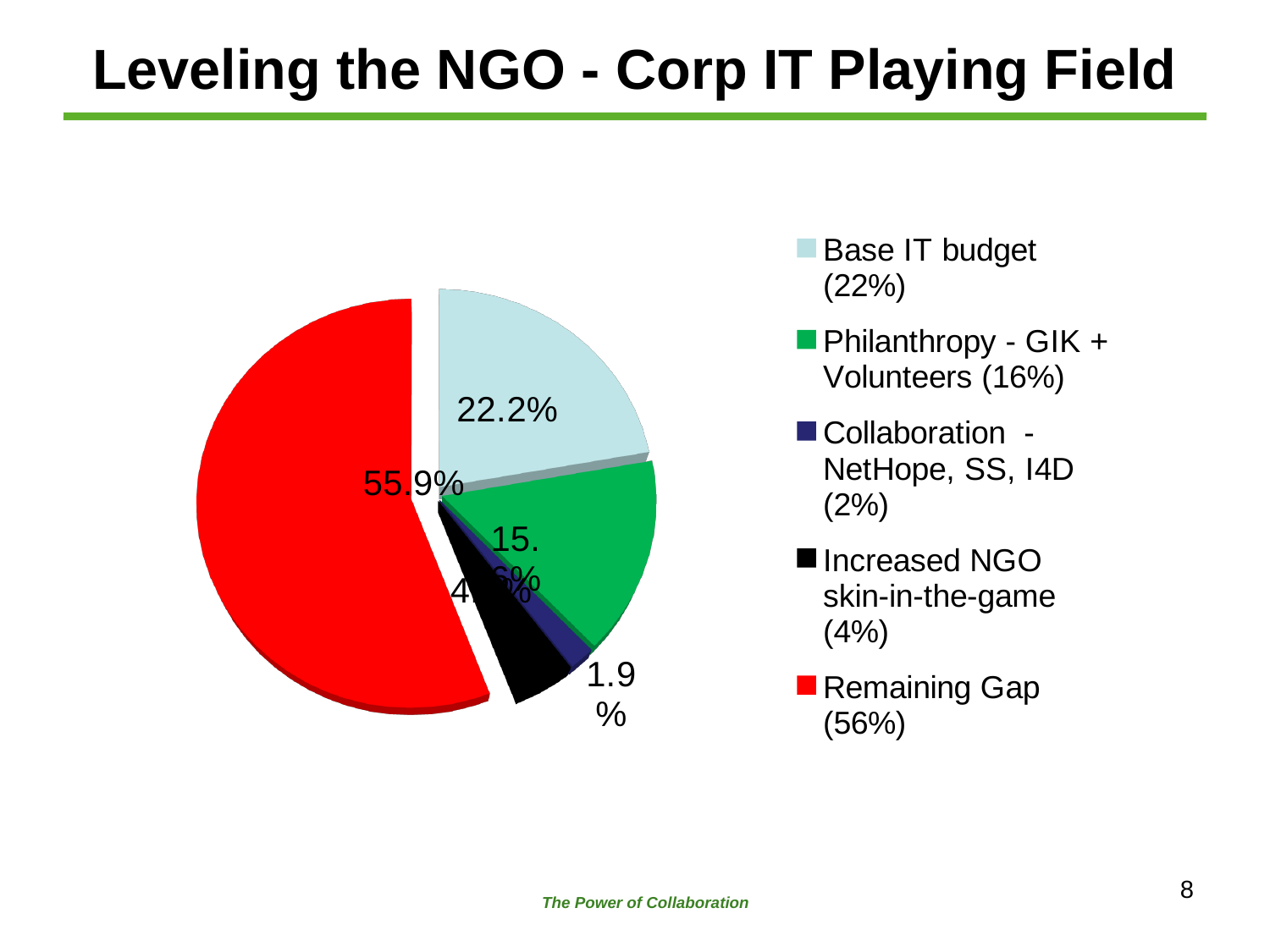
What is the difference in percentage points between the Remaining Gap slice (55.9%) and the Base IT budget slice (22.2%)? 33.7 percentage points What percentage does the legend give for Philanthropy - GIK + Volunteers? 16% Which is larger, the Base IT budget slice or the Remaining Gap slice? Remaining Gap Which is larger, the Base IT budget slice or the Philanthropy - GIK + Volunteers slice? Base IT budget What percentage does the Remaining Gap slice show? 55.9% What percentage does the Collaboration - NetHope, SS, I4D slice show? 1.9% How many slices does the pie chart have? 5 Which slice of the pie is the largest? Remaining Gap What percentage does the Base IT budget slice show? 22.2% What kind of chart is shown on the slide? Pie chart Which slice of the pie is the smallest? Collaboration - NetHope, SS, I4D What colour is the Remaining Gap slice? Red